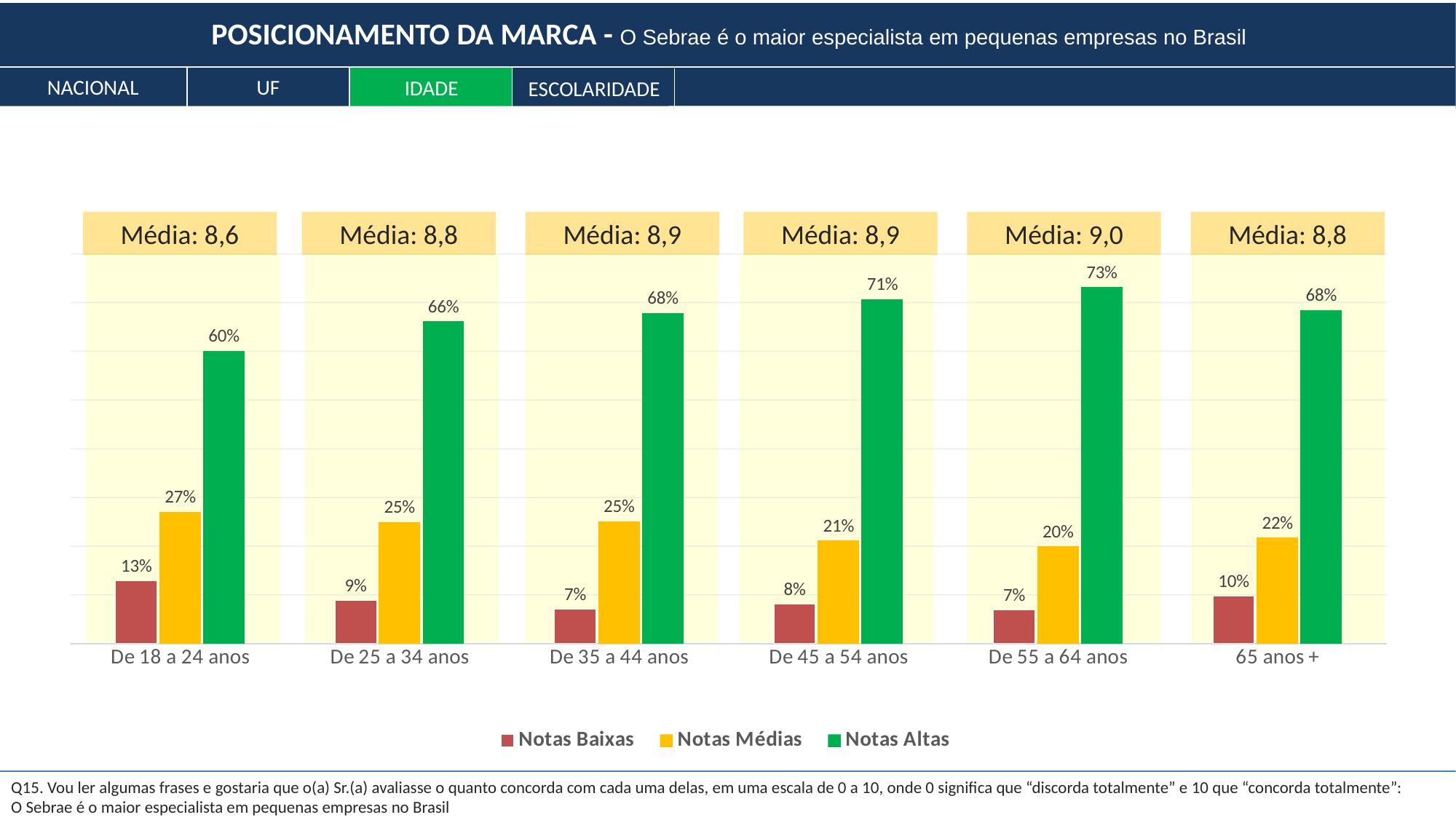
How many series does the legend list? 3 What is the difference between the Notas Altas values for 'De 55 a 64 anos' and 'De 18 a 24 anos'? 13% What is the Média shown above the 'De 55 a 64 anos' group? 9,0 Which is larger: Notas Baixas for 'De 18 a 24 anos' or Notas Baixas for '65 anos +'? De 18 a 24 anos What is the value of Notas Baixas for the 'De 45 a 54 anos' age group? 8% What is the value of Notas Médias for the '65 anos +' age group? 22% What kind of chart is shown on the slide? Bar chart How many age groups are shown on the x axis? 6 Which colour represents Notas Altas in the legend? Green Which age group has the lowest Notas Médias value? De 55 a 64 anos Which age group has the highest Notas Altas value? De 55 a 64 anos What is the value of Notas Altas for the 'De 18 a 24 anos' age group? 60%